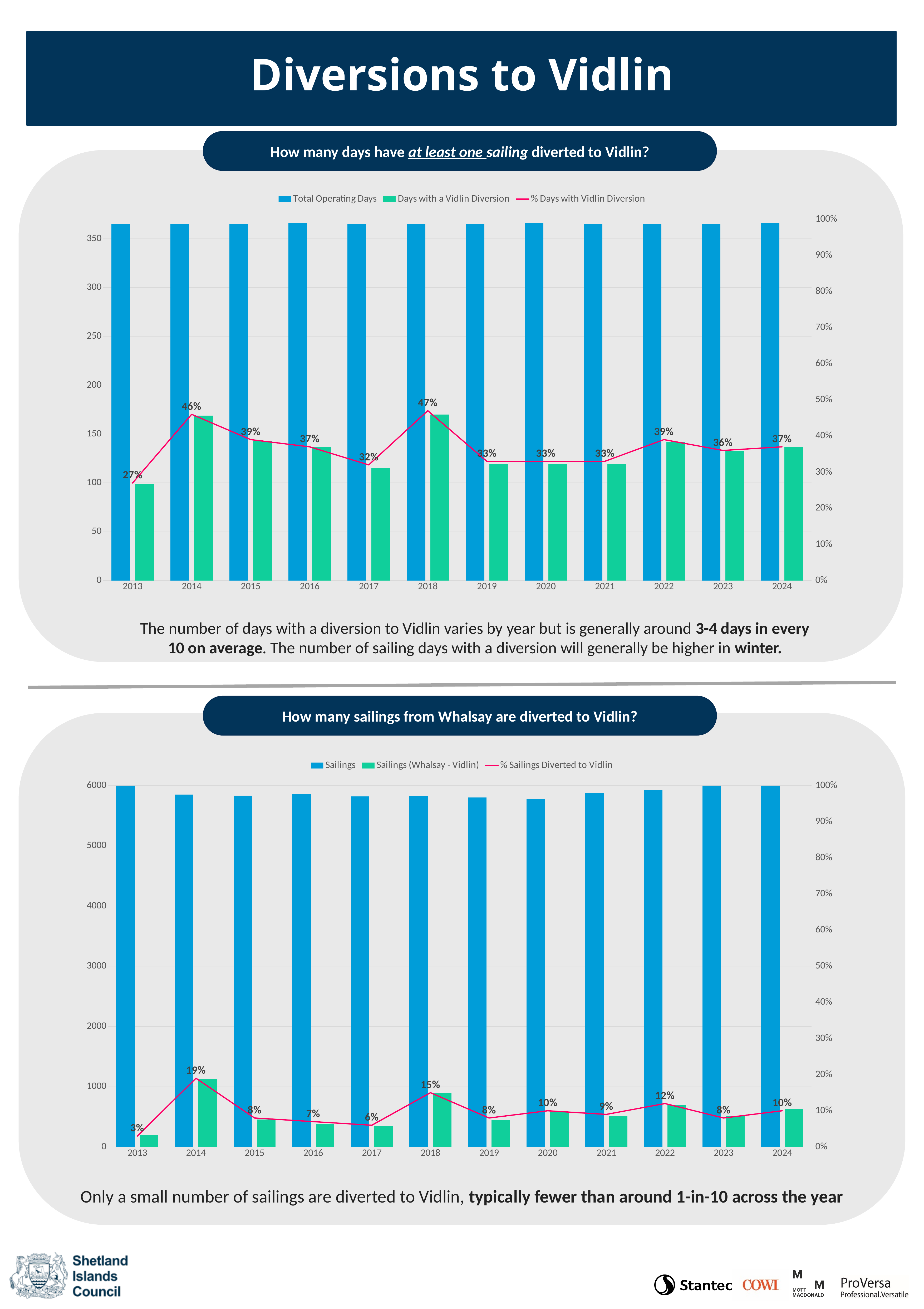
In the bottom chart (How many sailings from Whalsay are diverted to Vidlin?), does the % Sailings Diverted to Vidlin rise or fall from 2014 to 2017? fall In the top chart (How many days have at least one sailing diverted to Vidlin?), which year has the lowest % Days with Vidlin Diversion? 2013 In the bottom chart (How many sailings from Whalsay are diverted to Vidlin?), is the % Sailings Diverted to Vidlin higher in 2018 or 2020? 2018 In the bottom chart (How many sailings from Whalsay are diverted to Vidlin?), what is the % Sailings Diverted to Vidlin for 2022? 12% In the bottom chart (How many sailings from Whalsay are diverted to Vidlin?), which year has the highest % Sailings Diverted to Vidlin? 2014 In the top chart (How many days have at least one sailing diverted to Vidlin?), what is the difference between the % Days with Vidlin Diversion in 2014 and 2013? 19% In the bottom chart (How many sailings from Whalsay are diverted to Vidlin?), is the Sailings (Whalsay - Vidlin) value for 2014 greater or less than 1000? greater In the top chart (How many days have at least one sailing diverted to Vidlin?), what is the % Days with Vidlin Diversion for 2018? 47% In the top chart (How many days have at least one sailing diverted to Vidlin?), how many series does the legend list? 3 In the top chart (How many days have at least one sailing diverted to Vidlin?), how many years are shown on the x axis? 12 What kind of chart is the bottom chart (How many sailings from Whalsay are diverted to Vidlin?)? Bar chart with a line In the top chart (How many days have at least one sailing diverted to Vidlin?), is the Days with a Vidlin Diversion value for 2013 greater or less than 150? less